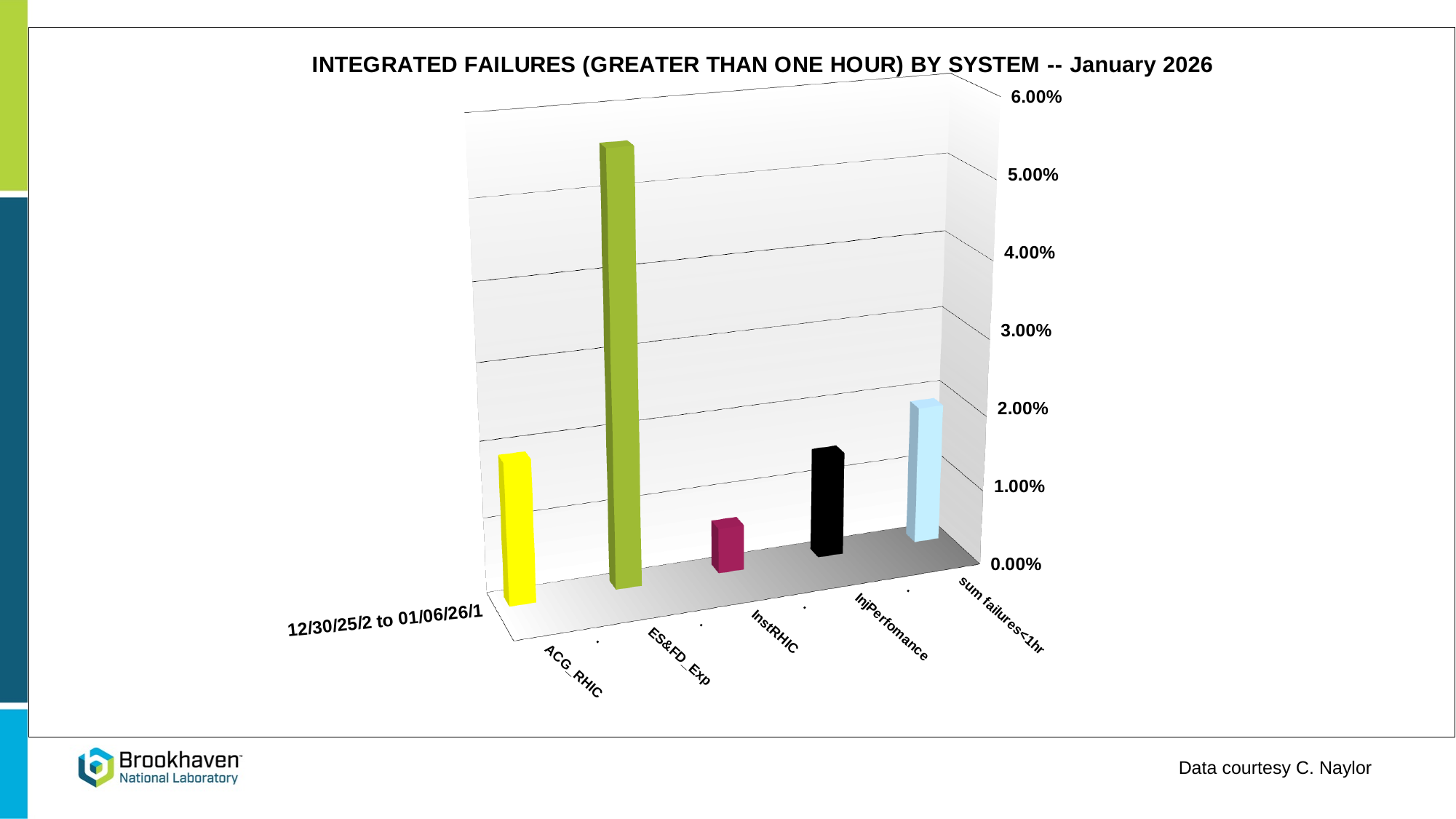
Is the value for ES&FD_Exp greater or less than 4.00%? greater Is the value for InstRHIC greater or less than 1.00%? less How many system categories are plotted in the chart? 5 Which is larger, the value for InstRHIC or the value for sum failures<1hr? sum failures<1hr Is the value for sum failures<1hr greater or less than 3.00%? less Which system has the lowest integrated failure percentage? InstRHIC What kind of chart is shown on the slide? bar chart Which is larger, the value for ES&FD_Exp or the value for ACG_RHIC? ES&FD_Exp What is the title of the chart? INTEGRATED FAILURES (GREATER THAN ONE HOUR) BY SYSTEM -- January 2026 What colour is the bar for ES&FD_Exp? green Which system has the highest integrated failure percentage? ES&FD_Exp